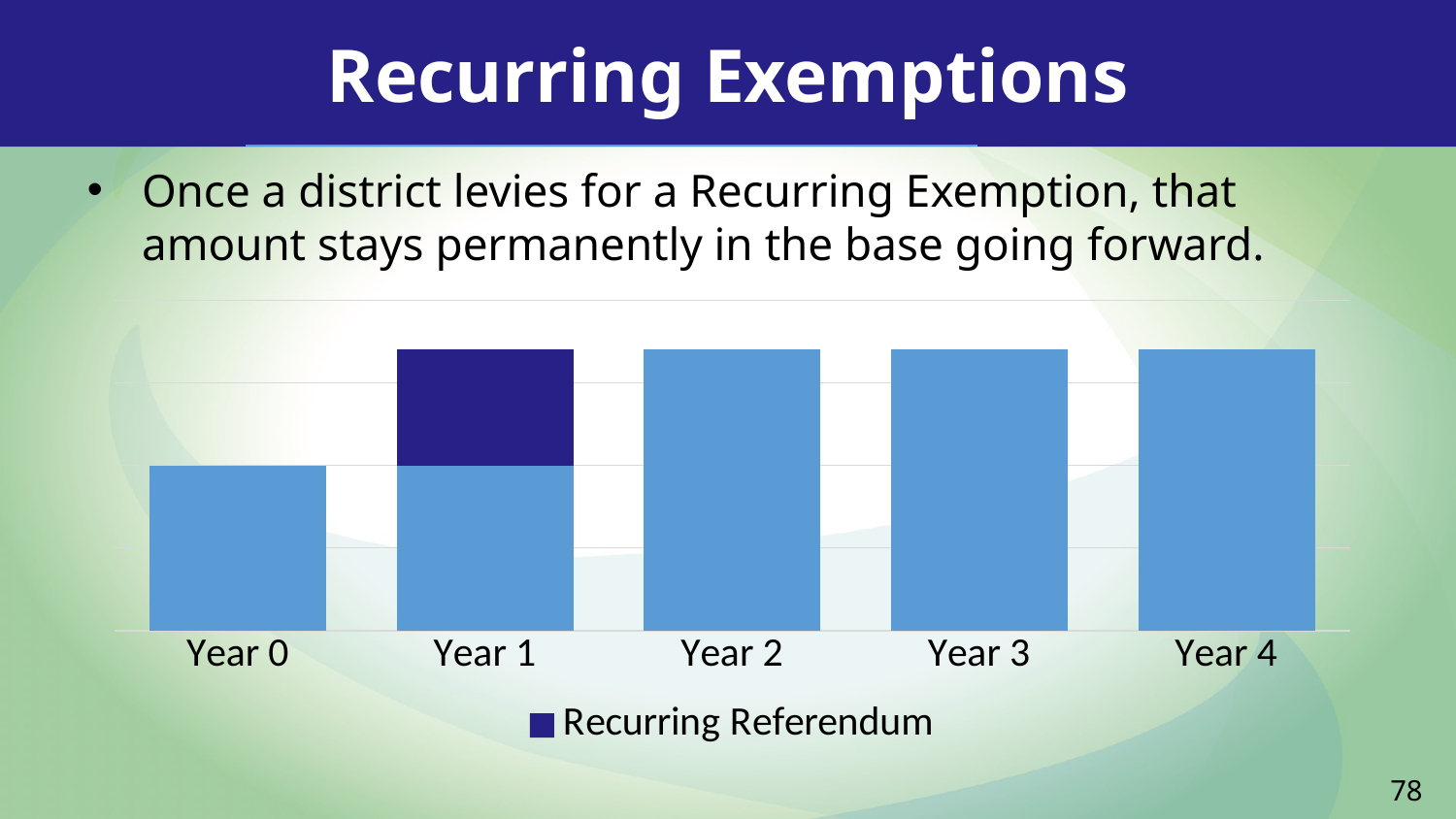
Which category's bar includes a dark blue segment on top? Year 1 What is the label of the last category on the x axis? Year 4 What kind of chart is shown on the slide? bar chart How many series does the chart's legend list? 1 Which is larger, the bar for Year 0 or the bar for Year 2? Year 2 How many categories are shown on the x axis of the chart? 5 Which category has the lowest total bar in the chart? Year 0 What is the label of the first category on the x axis? Year 0 What is the series name shown in the chart's legend? Recurring Referendum Which is larger, the bar for Year 3 or the bar for Year 0? Year 3